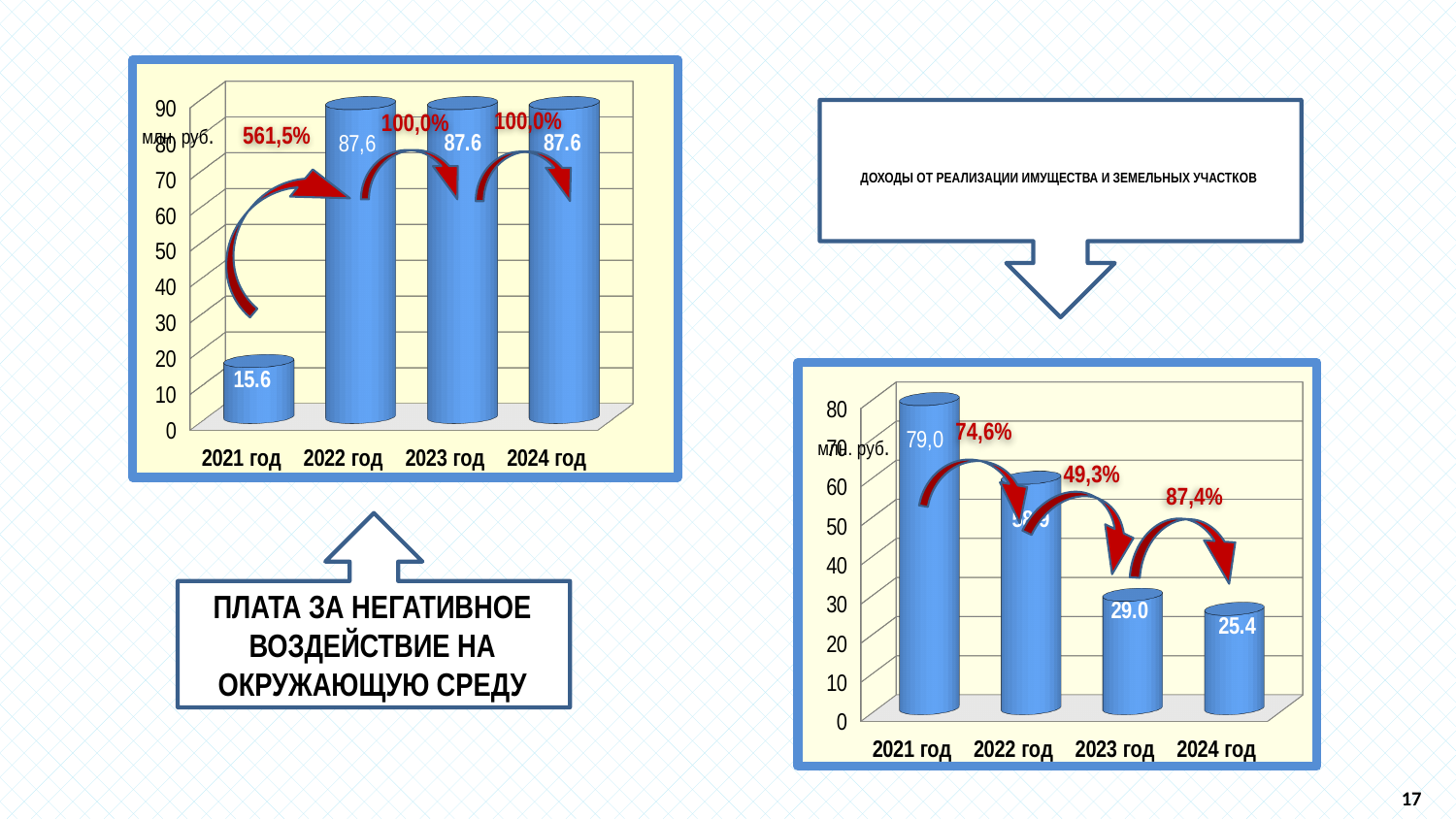
In the right chart (Доходы от реализации имущества и земельных участков), what is the value for 2021 год? 79,0 In the left chart, what is the difference between the values for 2022 год and 2021 год? 72.0 In the right chart, which year has the highest value? 2021 год In the left chart (Плата за негативное воздействие на окружающую среду), what is the value for 2021 год? 15.6 In the right chart (Доходы от реализации имущества и земельных участков), what is the value for 2024 год? 25.4 In the left chart, which year has the lowest value? 2021 год In the right chart, do the values rise or fall from 2021 год to 2024 год? fall What type of chart is the left chart? bar chart In the right chart, is the value for 2023 год greater or less than 2024 год? greater In the left chart, what percentage is shown on the arrow between 2021 год and 2022 год? 561,5% How many years (categories) are shown in the right chart? 4 In the left chart (Плата за негативное воздействие на окружающую среду), what is the value for 2023 год? 87.6